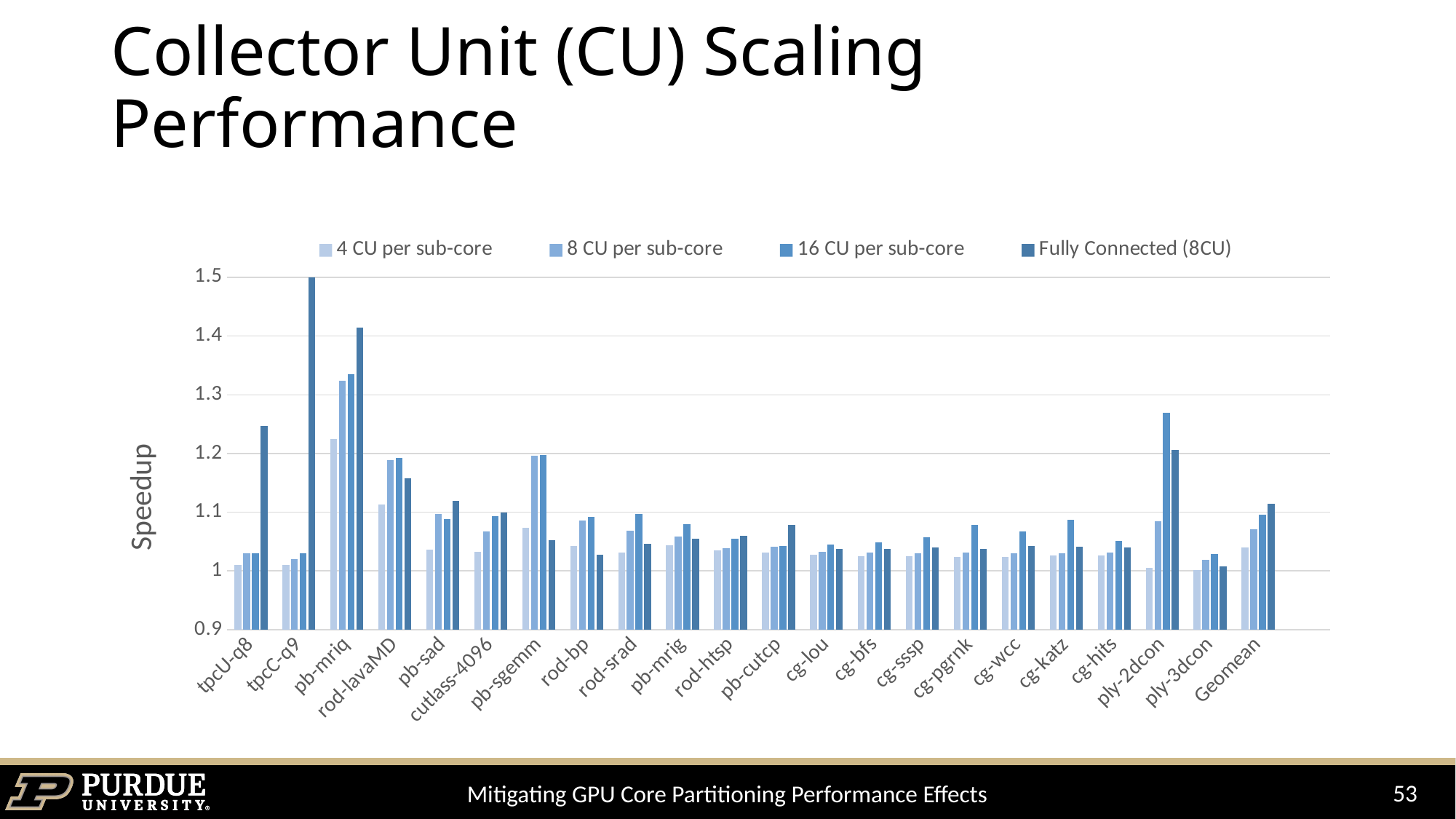
Which category has the highest Fully Connected (8CU) bar? tpcC-q9 Which category has the tallest bar in the chart? tpcC-q9 For Geomean, which is larger: the Fully Connected (8CU) value or the 4 CU per sub-core value? Fully Connected (8CU) Which is larger: the 4 CU per sub-core value for pb-mriq or the 4 CU per sub-core value for rod-lavaMD? pb-mriq Which category has the highest 4 CU per sub-core bar? pb-mriq Is the Fully Connected (8CU) value for tpcU-q8 greater or less than 1.2? greater How many benchmark categories are shown along the x axis (including Geomean)? 22 Is the 16 CU per sub-core value for ply-2dcon greater or less than 1.2? greater What is the label of the y axis? Speedup What kind of chart is shown on the slide? bar chart How many series does the legend list? 4 Is the 16 CU per sub-core value for tpcC-q9 greater or less than 1.4? less